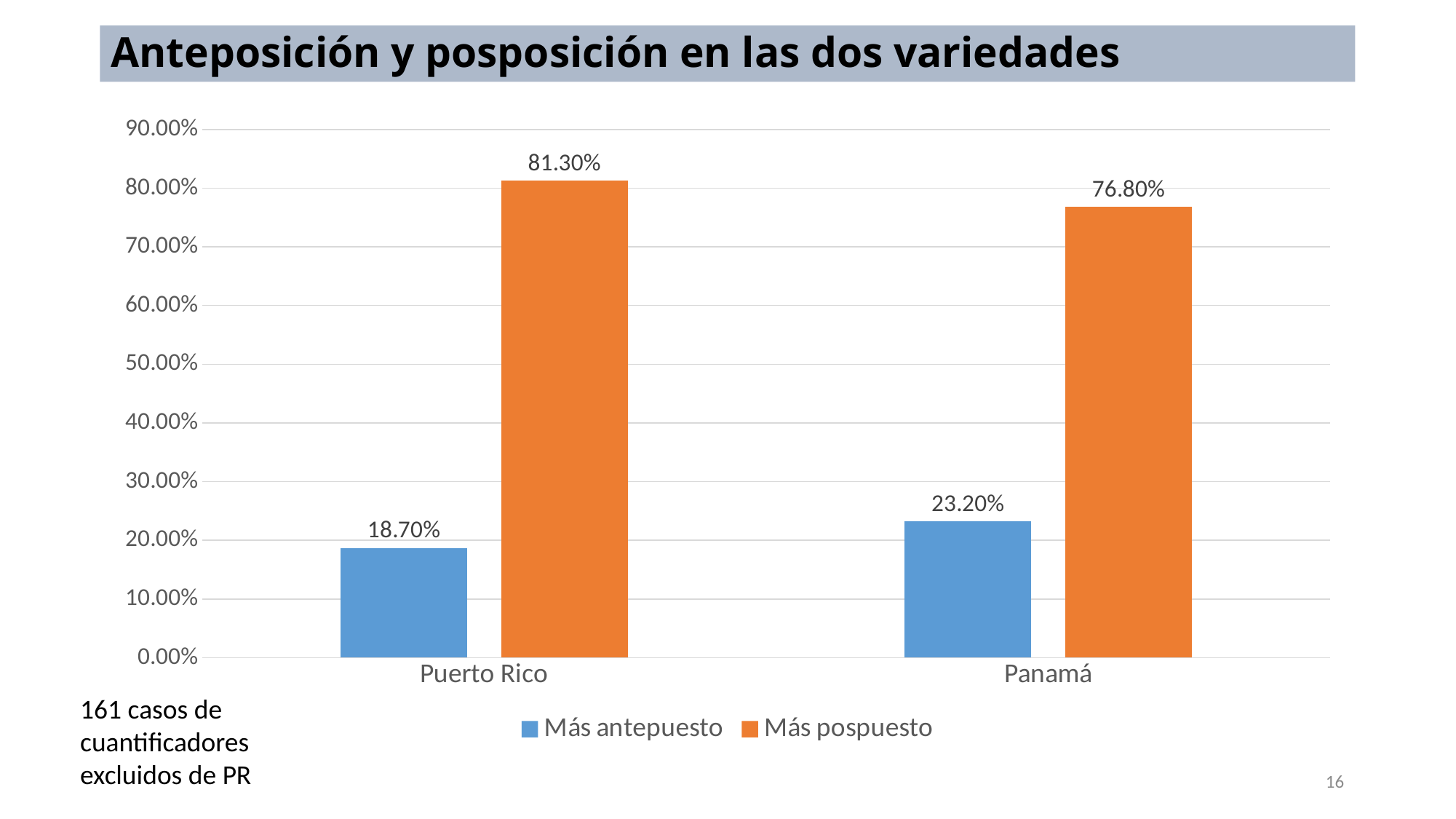
What is the difference between the Más pospuesto values for Puerto Rico and Panamá? 4.50% What is the difference between Más pospuesto and Más antepuesto in Panamá? 53.60% How many categories are shown on the x axis? 2 Which is larger: Más antepuesto in Panamá or Más antepuesto in Puerto Rico? Más antepuesto in Panamá What is the value for Más pospuesto in Puerto Rico? 81.30% Which category has the lowest Más antepuesto value? Puerto Rico What is the value for Más antepuesto in Puerto Rico? 18.70% What is the value for Más antepuesto in Panamá? 23.20% What kind of chart is shown on the slide? Bar chart Which category has the highest Más pospuesto value? Puerto Rico What is the value for Más pospuesto in Panamá? 76.80% How many series does the legend list? 2